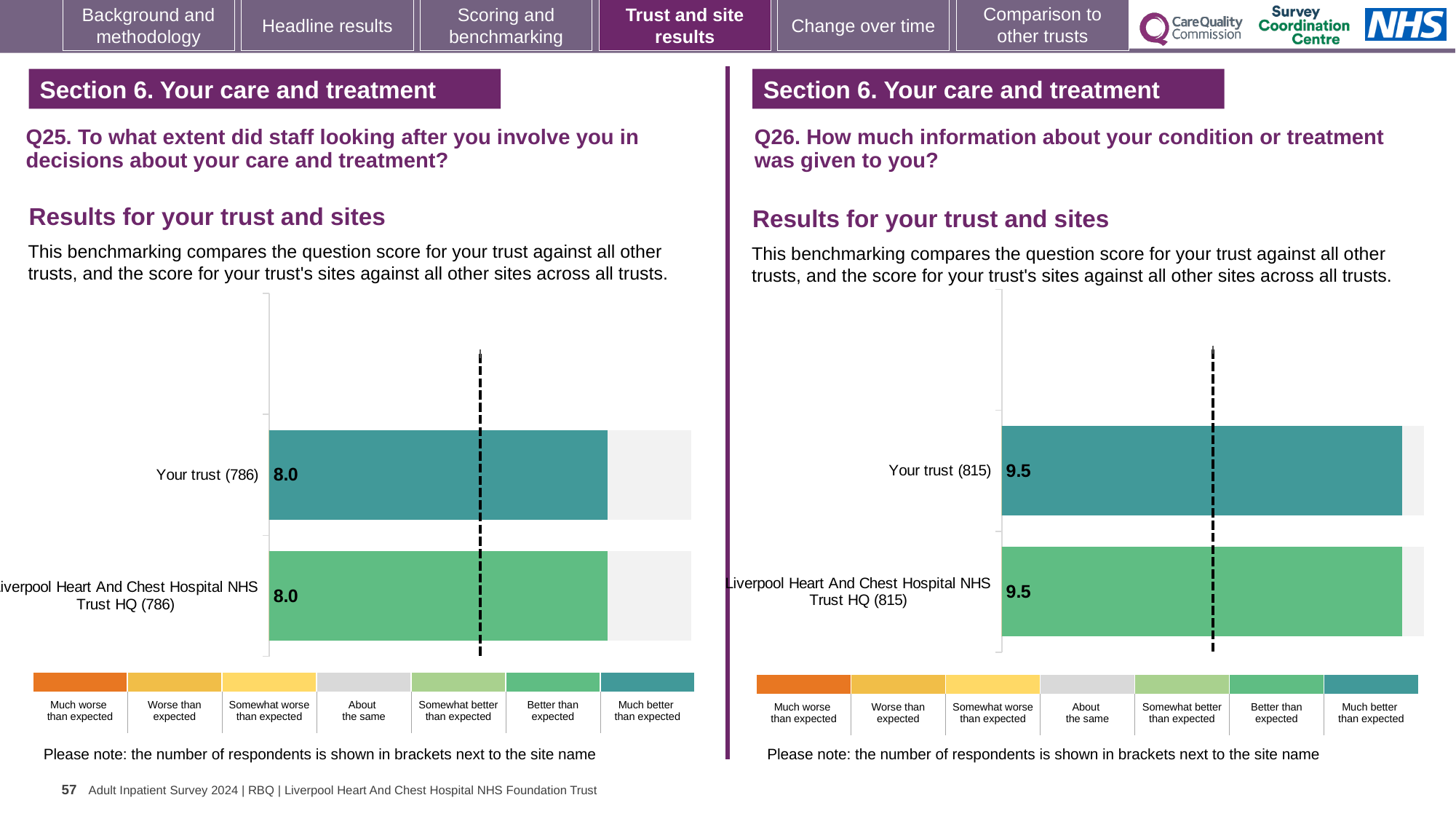
How many bars are plotted on the Q25 chart (left)? 2 On the Q26 chart (right), what is the score for Your trust (815)? 9.5 On the Q25 chart (left), what is the difference between the score for Your trust and the score for Liverpool Heart And Chest Hospital NHS Trust HQ? 0.0 On the Q25 chart (left), which colour key category does the 'Your trust (786)' bar colour correspond to? Much better than expected On the Q26 chart (right), what is the score for Liverpool Heart And Chest Hospital NHS Trust HQ (815)? 9.5 How many respondents are shown in brackets for Your trust on the Q26 chart (right)? 815 How many bars are plotted on the Q26 chart (right)? 2 On the Q25 chart (left), what is the score for Your trust (786)? 8.0 On the Q26 chart (right), what is the difference between the score for Your trust and the score for Liverpool Heart And Chest Hospital NHS Trust HQ? 0.0 How many categories does the colour key below the Q25 chart (left) list? 7 On the Q25 chart (left), what is the score for Liverpool Heart And Chest Hospital NHS Trust HQ (786)? 8.0 What kind of chart is the Q26 chart (right)? Bar chart